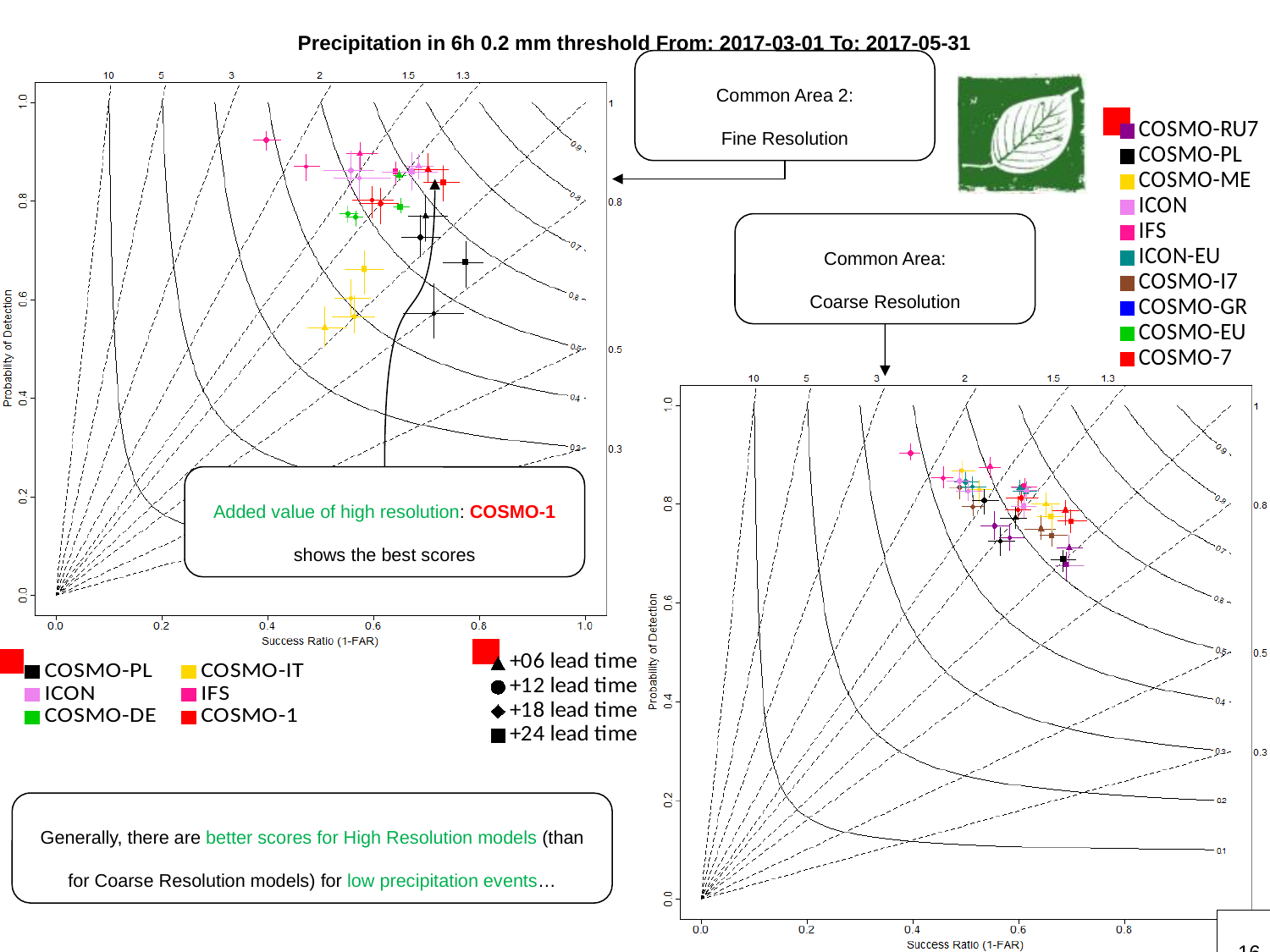
How many models does the legend of the left chart (Fine Resolution) list? 6 In the left chart (Fine Resolution), which has the higher Probability of Detection: the highest IFS (pink) point or the lowest COSMO-PL (black) point? the IFS point How many lead times are listed in the marker-shape legend below the left chart? 4 According to the annotation on the left chart, which model shows the best scores? COSMO-1 In the left chart (Fine Resolution), is the Probability of Detection of the highest IFS (pink) point greater or less than 0.8? greater What is the title printed at the top of the slide above the charts? Precipitation in 6h 0.2 mm threshold From: 2017-03-01 To: 2017-05-31 What is the x-axis label of the two charts? Success Ratio (1-FAR) How many models does the legend of the right chart (Coarse Resolution) list? 10 In the left chart (Fine Resolution), is the Probability of Detection of the lowest COSMO-IT (yellow) point greater or less than 0.8? less In the left chart (Fine Resolution), is the Success Ratio of the highest IFS (pink) point greater or less than 0.6? less What kind of chart is the left chart (Common Area 2: Fine Resolution)? scatter plot